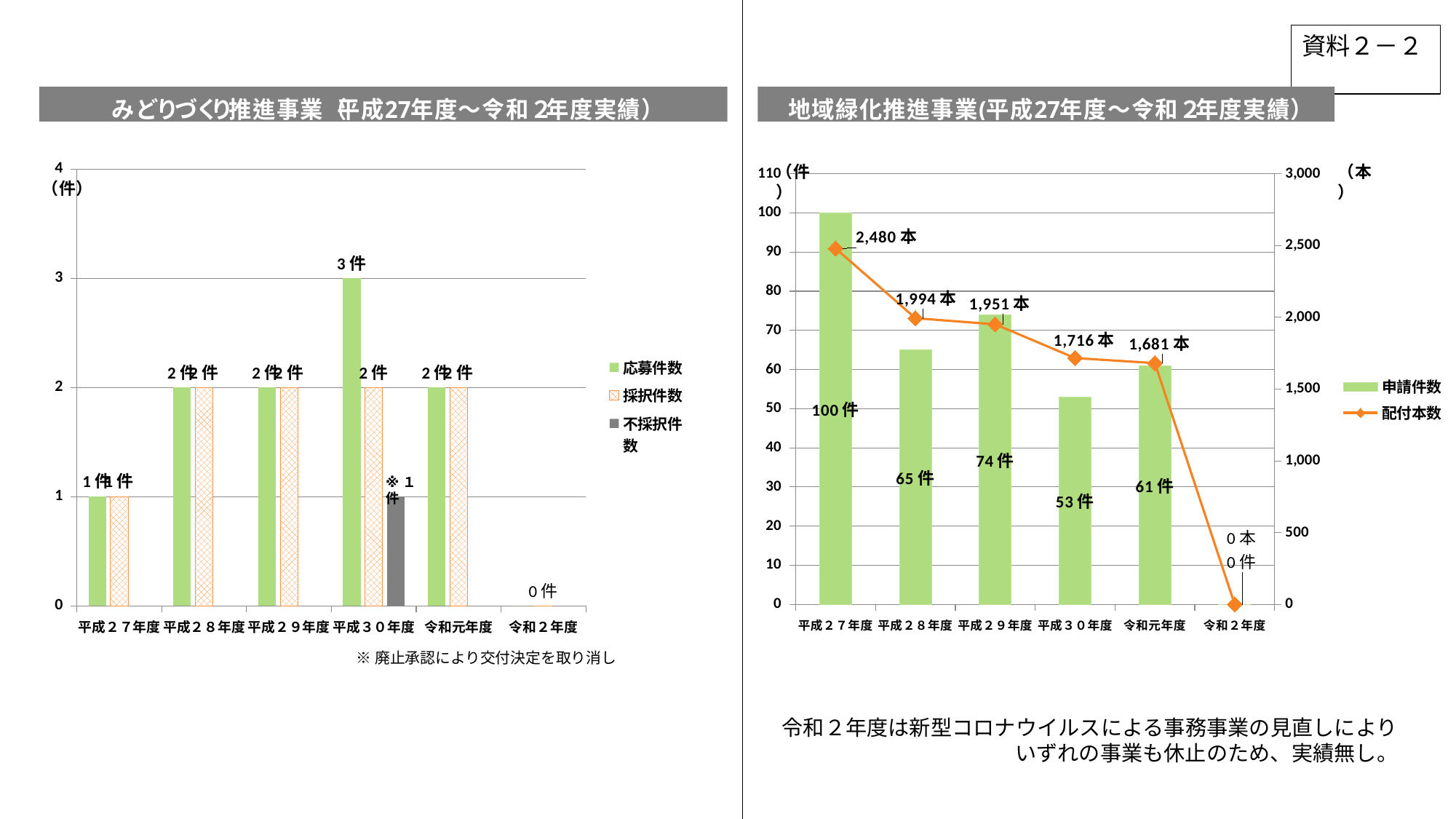
In the 地域緑化推進事業 chart, what is the 配付本数 value for 平成28年度? 1,994本 In the 地域緑化推進事業 chart, is the 申請件数 for 平成29年度 greater or less than the 申請件数 for 平成30年度? greater What kind of chart is the みどりづくり推進事業 chart? bar chart In the みどりづくり推進事業 chart, how many years are shown on the x axis? 6 In the 地域緑化推進事業 chart, how many series does the legend list? 2 In the 地域緑化推進事業 chart, what is the difference in 配付本数 between 平成27年度 and 令和元年度? 799本 In the みどりづくり推進事業 chart, what is the 応募件数 value for 平成30年度? 3件 In the 地域緑化推進事業 chart, which year has the highest 申請件数? 平成27年度 In the 地域緑化推進事業 chart, does the 配付本数 rise or fall from 平成27年度 to 令和2年度? fall In the みどりづくり推進事業 chart, which year has the highest 応募件数? 平成30年度 In the みどりづくり推進事業 chart, how many series does the legend list? 3 In the 地域緑化推進事業 chart, what is the 申請件数 value for 平成27年度? 100件